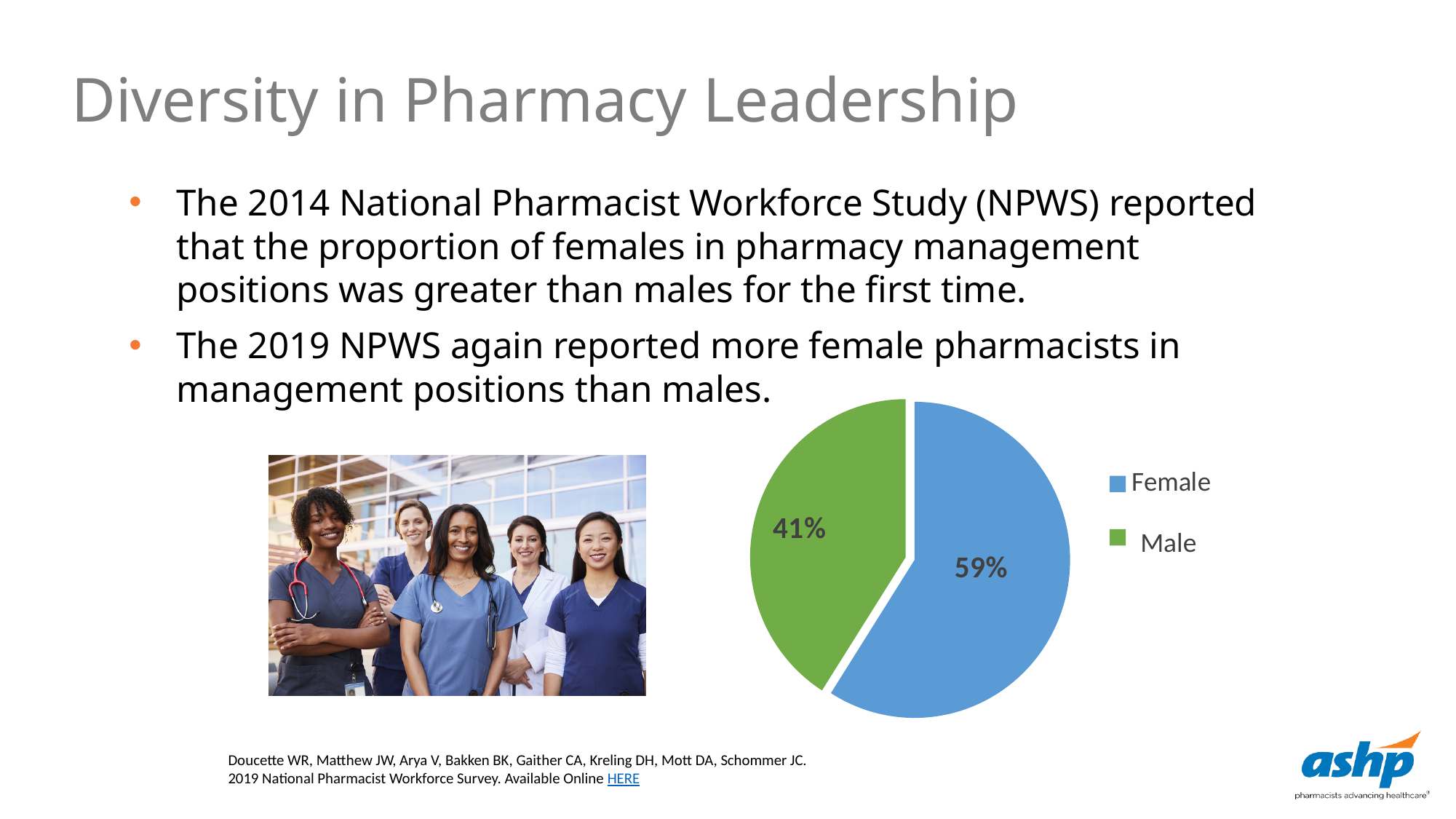
Which slice is larger, Female or Male? Female Is the Male share of the pie chart greater or less than 50%? less How many slices does the pie chart have? 2 What percentage of the pie chart is labelled Female? 59% What kind of chart is shown on the slide? Pie chart What colour is the Female slice in the pie chart? Blue Which category has the largest slice in the pie chart? Female What percentage of the pie chart is labelled Male? 41% Which category has the smallest slice in the pie chart? Male What colour is the Male slice in the pie chart? Green What is the difference in percentage points between the Female and Male slices? 18 How many entries does the legend of the pie chart list? 2